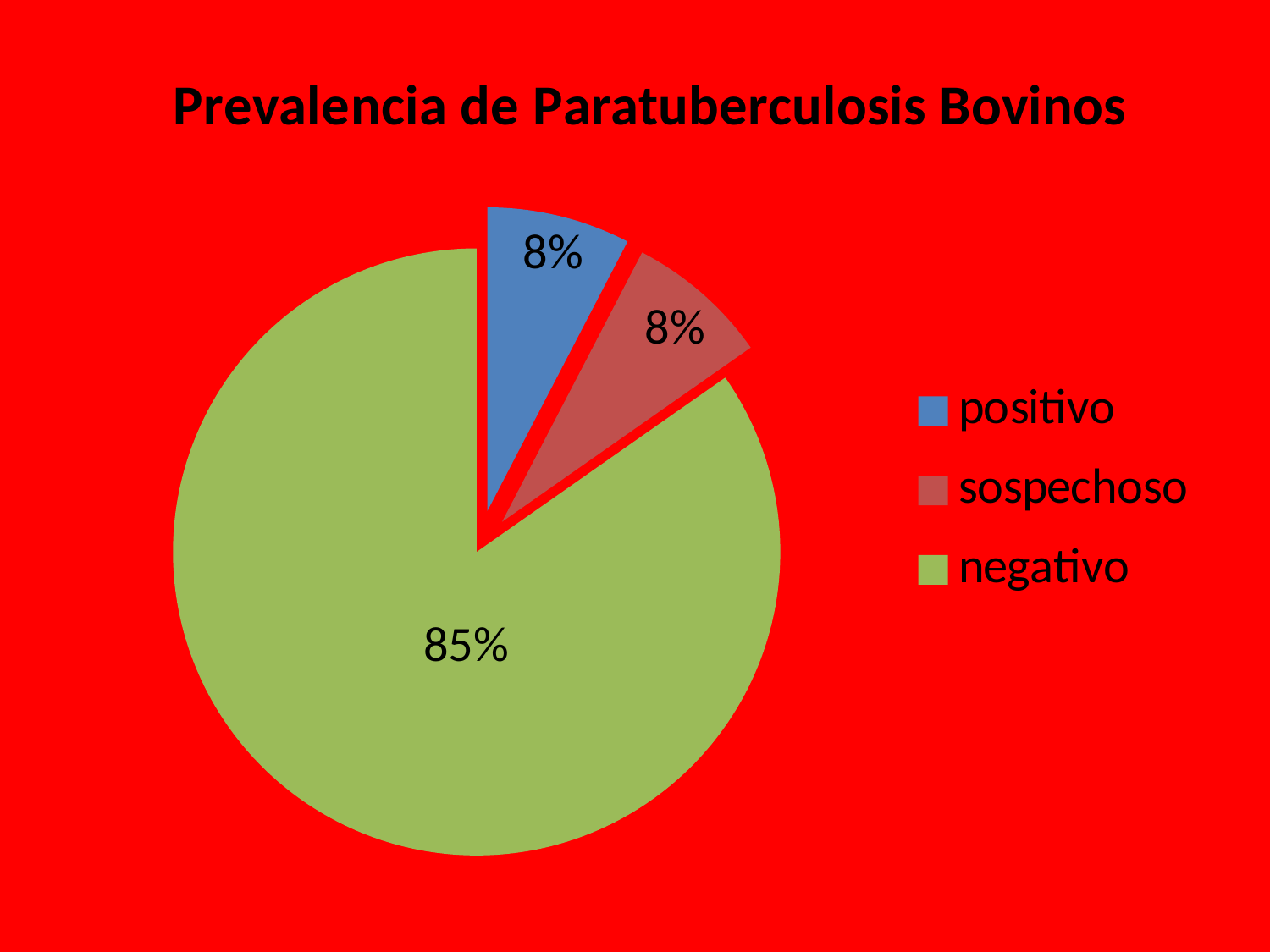
What colour is the negativo slice? green Which is larger, the negativo slice or the sospechoso slice? negativo How many slices does the pie chart have? 3 What share of the pie is labelled positivo? 8% How many categories does the legend list? 3 What is the difference between the negativo share and the positivo share? 77% What share of the pie is labelled sospechoso? 8% What is the title of the chart? Prevalencia de Paratuberculosis Bovinos What kind of chart is shown on the slide? pie chart Which category has the largest slice of the pie? negativo What share of the pie is labelled negativo? 85%